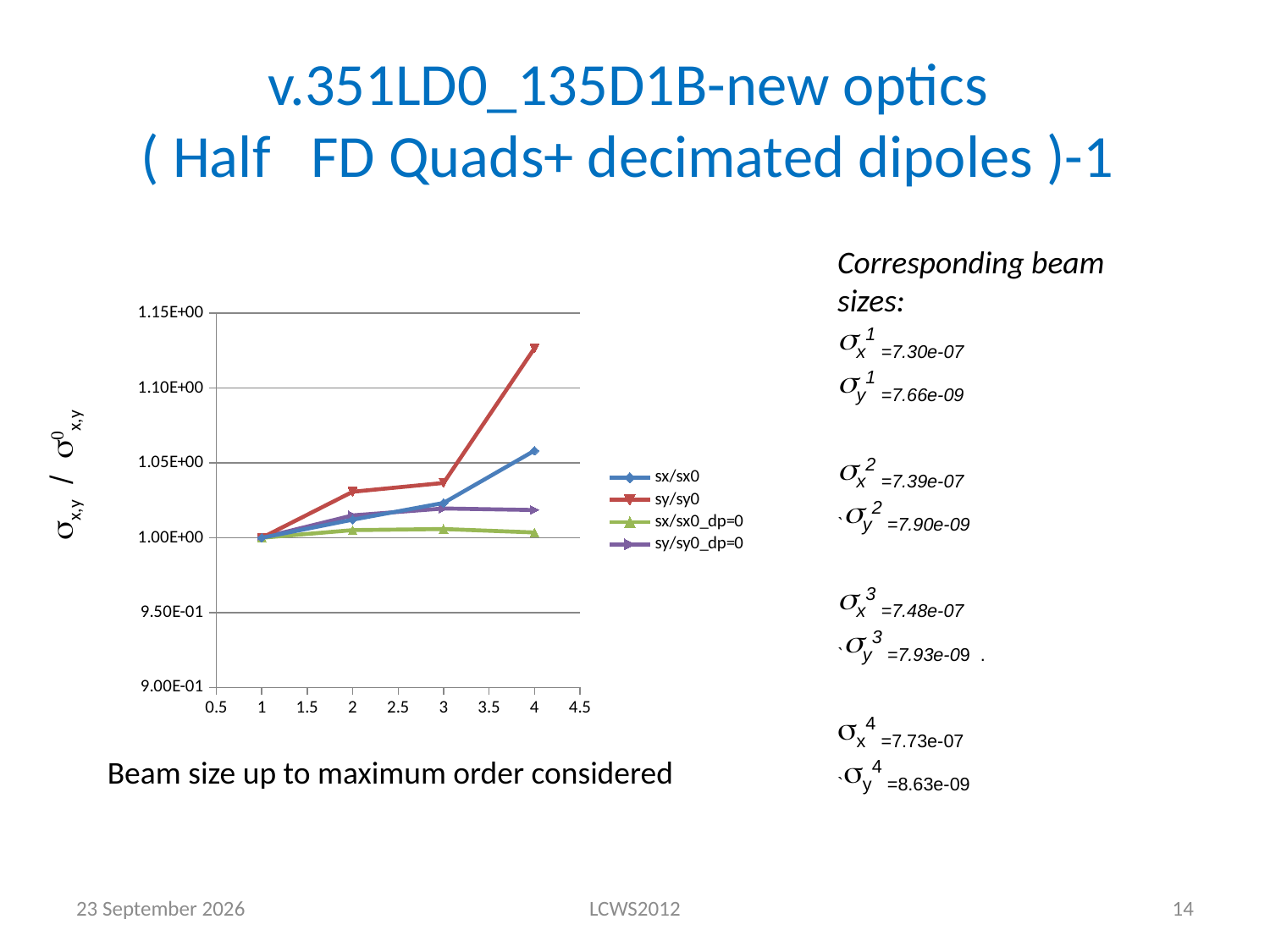
At x = 2, which series has the larger value, sy/sy0 or sx/sx0? sy/sy0 What kind of chart is shown on the slide? line chart How many series does the chart legend list? 4 Is the value of sx/sx0 at x = 4 greater or less than 1.10E+00? less What is the value of sx/sx0 at x = 1? 1.00E+00 Is the value of sy/sy0 at x = 4 greater or less than 1.10E+00? greater Does the sy/sy0 series rise or fall as x increases from 1 to 4? rises Which series has the lowest value at x = 4? sx/sx0_dp=0 Which series has the highest value at x = 4? sy/sy0 Is the value of sy/sy0_dp=0 at x = 4 greater or less than 1.05E+00? less How many data points does the sy/sy0 series have? 4 What is the caption written below the chart? Beam size up to maximum order considered